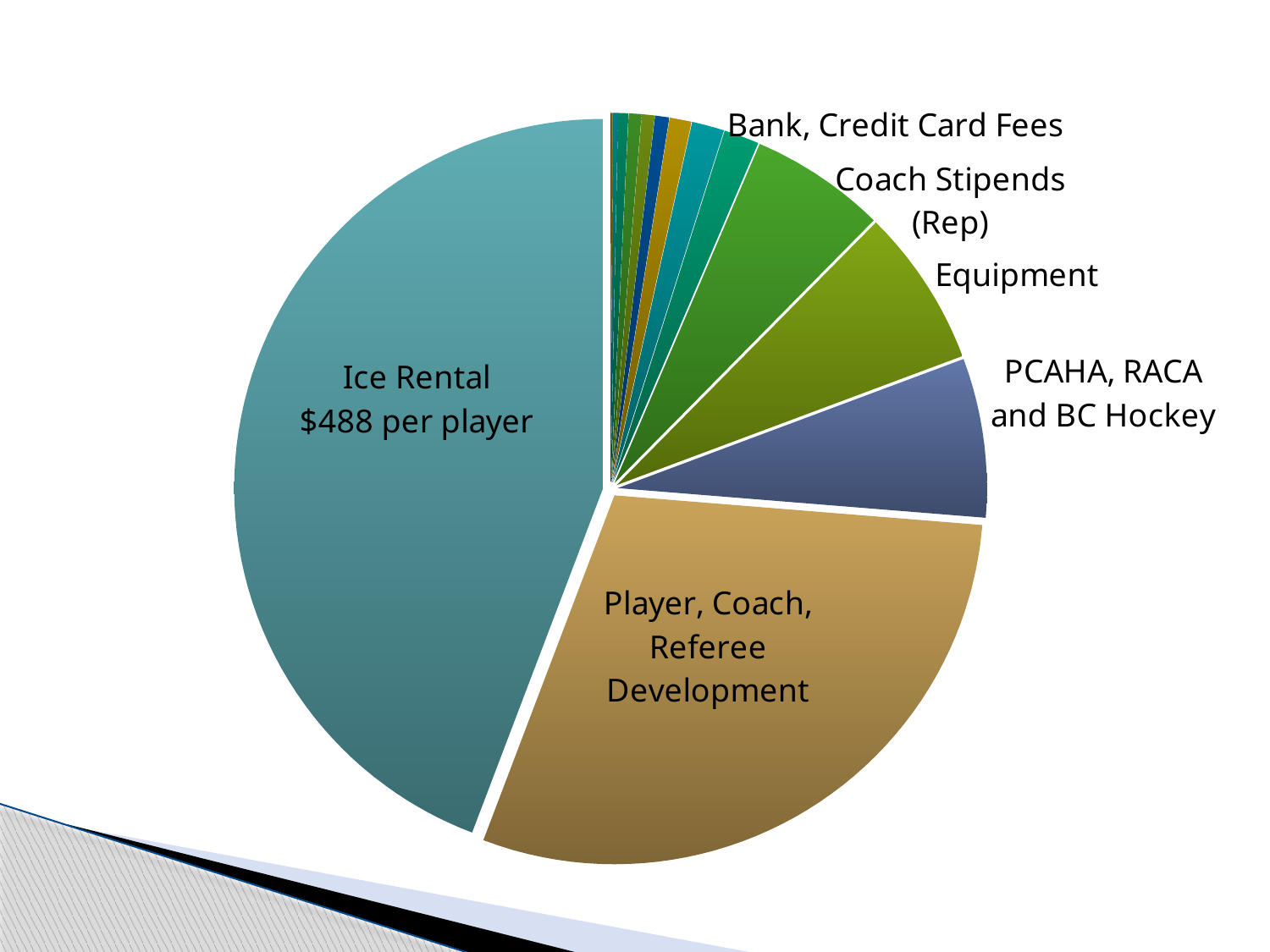
What per-player value is printed on the Ice Rental slice? $488 per player Of the labelled slices, which is the smallest? Bank, Credit Card Fees What kind of chart is shown on the slide? pie chart Which slice is larger, Ice Rental or Player, Coach, Referee Development? Ice Rental Which category has the largest slice of the pie? Ice Rental Which slice is larger, Player, Coach, Referee Development or Equipment? Player, Coach, Referee Development Which slice is larger, Equipment or Bank, Credit Card Fees? Equipment Which category has the second-largest slice of the pie? Player, Coach, Referee Development How many slices of the pie have a text label on the slide? 6